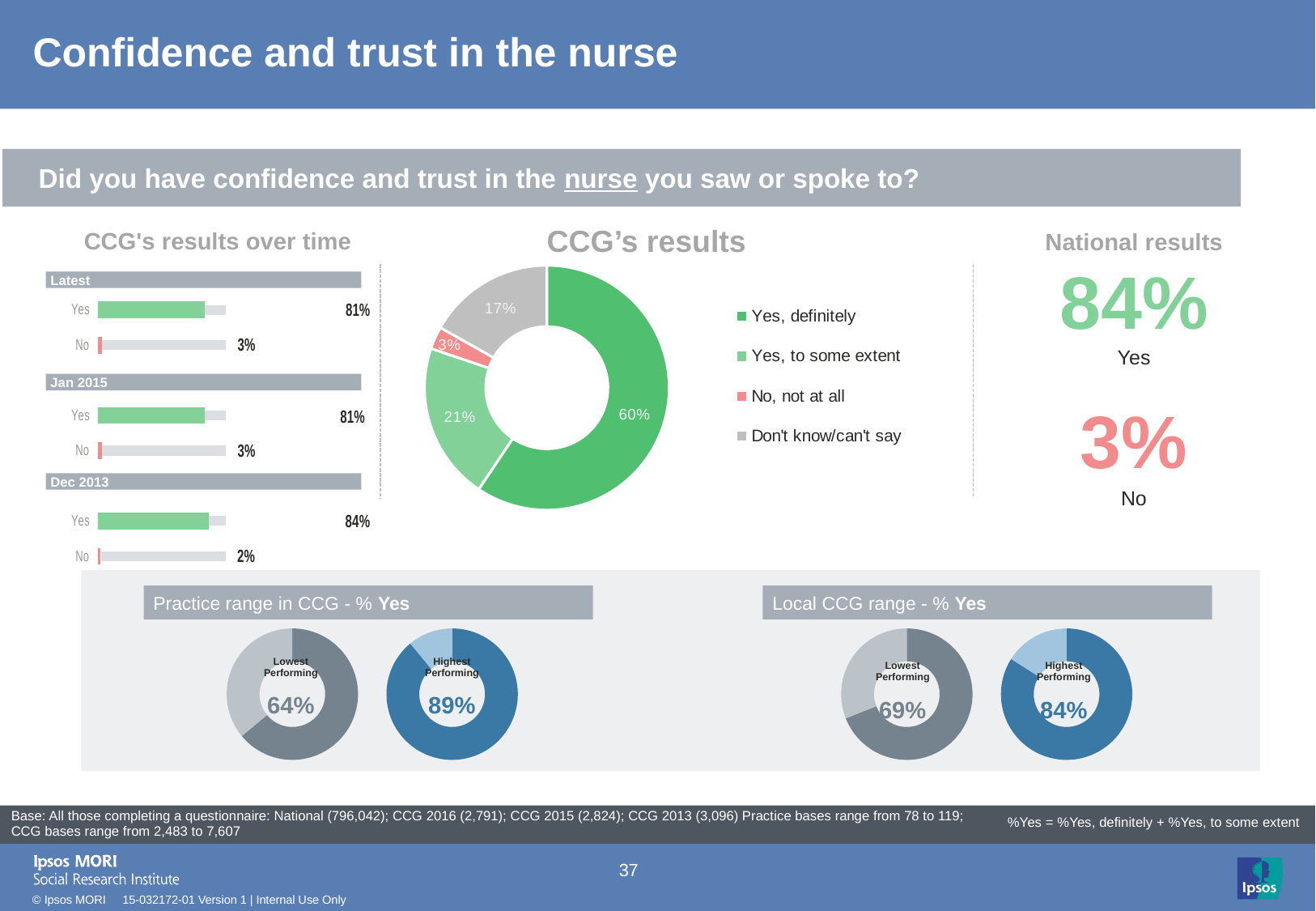
In the "CCG's results over time" chart, what is the No value for the Latest period? 3% In the "Local CCG range - % Yes" charts, what is the difference between the Highest Performing and Lowest Performing values? 15 percentage points In the "CCG's results over time" chart, which period has the highest Yes value? Dec 2013 In the "CCG's results" donut chart, what percentage answered "Yes, definitely"? 60% In the "Practice range in CCG - % Yes" charts, what is the Highest Performing value? 89% In the "CCG's results" donut chart, what percentage answered "Don't know/can't say"? 17% How many response categories does the legend of the "CCG's results" donut chart list? 4 In the "CCG's results" donut chart, which response has the largest share? Yes, definitely In the "CCG's results over time" chart, how did the Yes value change from Dec 2013 to Jan 2015? It fell from 84% to 81% In the "CCG's results" donut chart, which response has the smallest share? No, not at all In the "CCG's results over time" chart, what is the Yes value for Dec 2013? 84% In the "CCG's results" donut chart, what is the difference between the "Yes, definitely" and "Yes, to some extent" shares? 39 percentage points